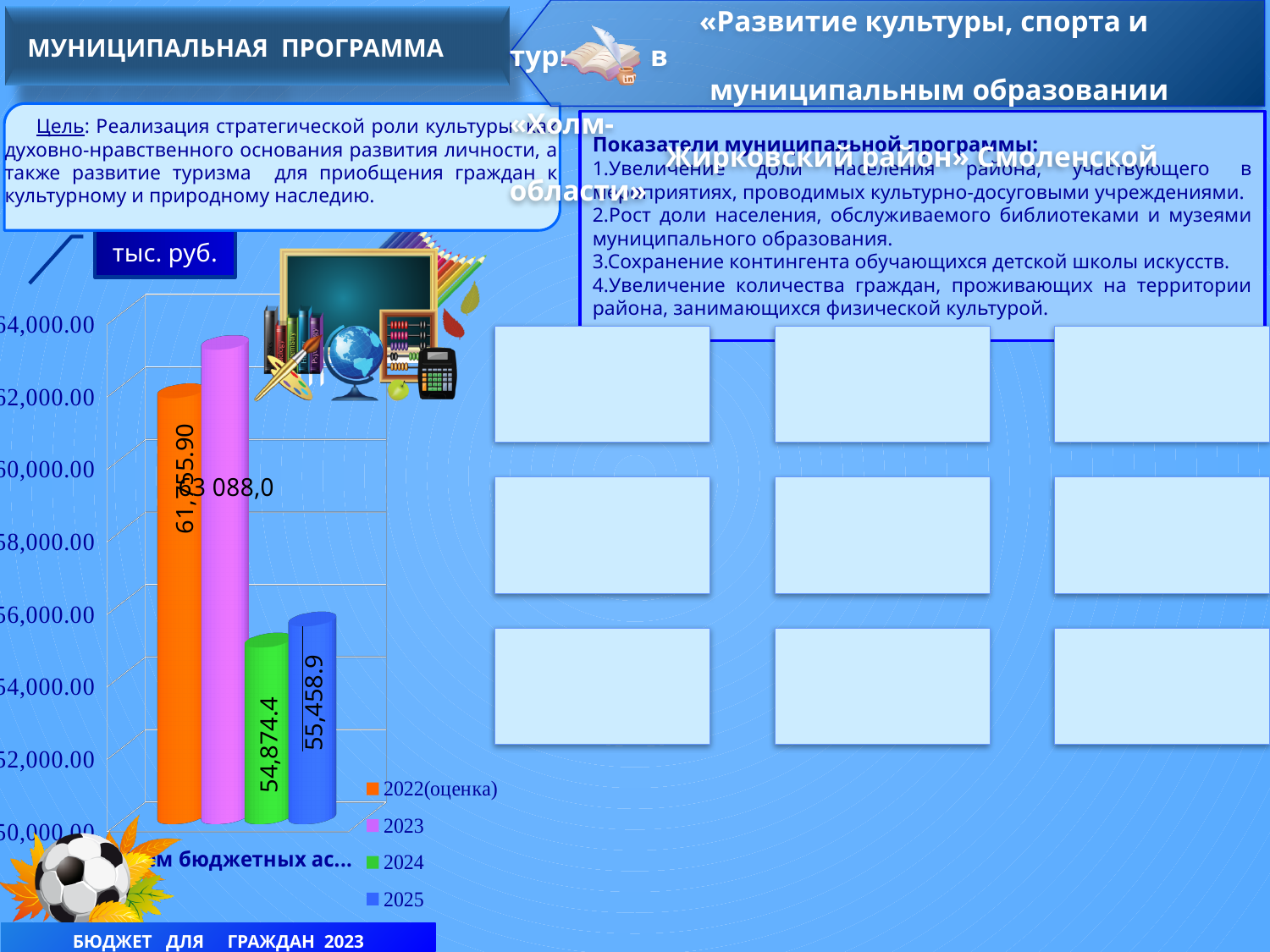
What is the difference between the values for 2025 and 2024? 584.5 Which is larger, the value for 2024 or the value for 2025? 2025 What is the value shown for 2024? 54,874.4 How many series does the chart legend list? 4 What is the value shown for 2023? 63 088,0 What is the value shown for 2025? 55,458.9 How many bars are plotted in the chart? 4 Which year has the lowest bar in the chart? 2024 Which year has the highest bar in the chart? 2023 What type of chart is shown on the slide? bar chart Is the value for 2022(оценка) greater or less than 60,000.00? greater What unit is indicated for the chart values? тыс. руб.